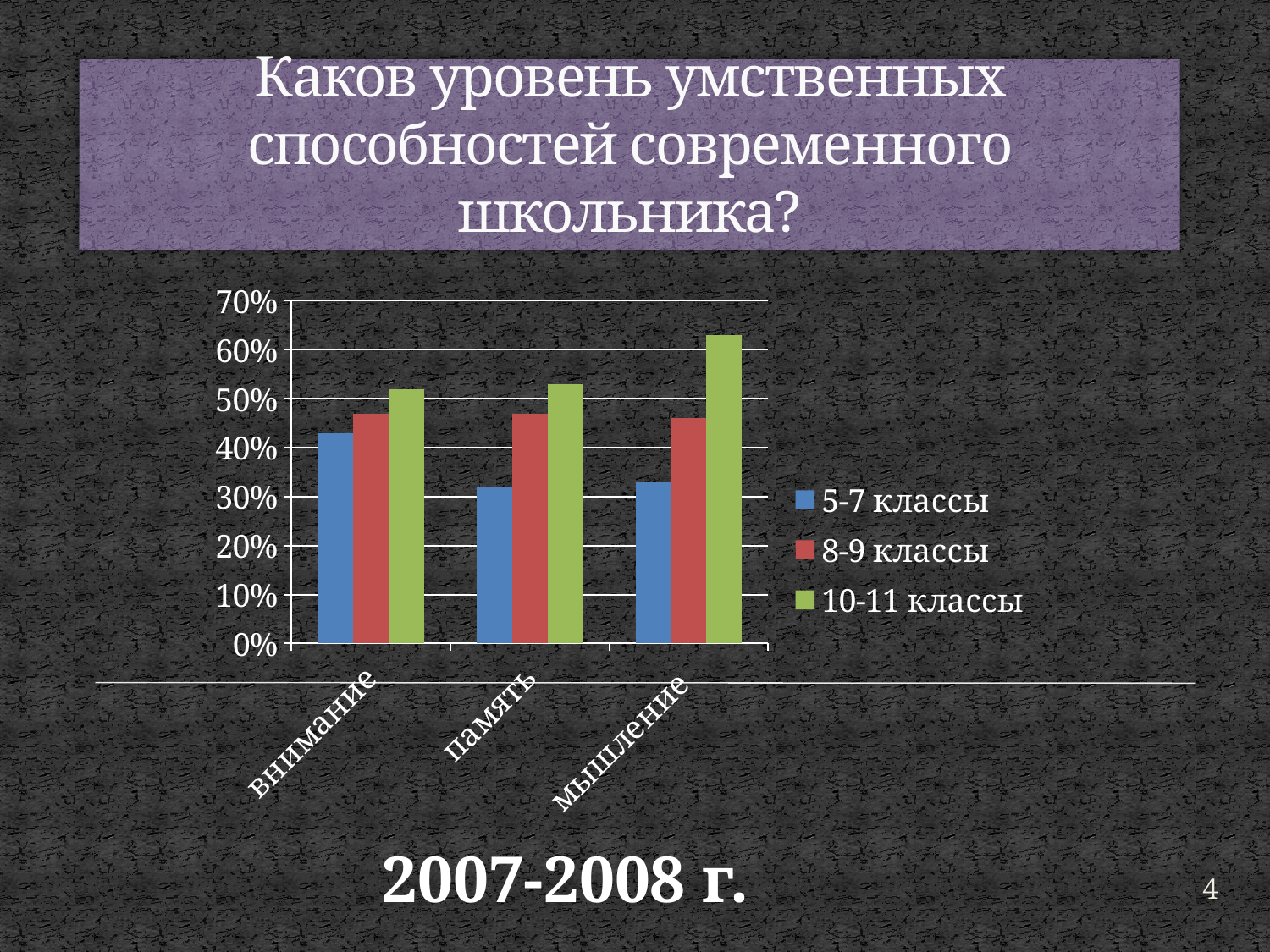
Is the value for 10-11 классы in мышление greater or less than 60%? greater What kind of chart is shown on the slide? bar chart Which series and category has the tallest bar in the chart? 10-11 классы, мышление For the 5-7 классы series, which category has the highest value? внимание For the 10-11 классы series, which category has the highest value? мышление How many categories are shown on the x axis of the chart? 3 Is the value for 5-7 классы in внимание greater or less than 40%? greater For мышление, which is larger: the value for 10-11 классы or for 5-7 классы? 10-11 классы For память, which is larger: the value for 8-9 классы or for 5-7 классы? 8-9 классы Is the value for 5-7 классы in память greater or less than 40%? less How many series does the chart's legend list? 3 What colour are the bars for the 10-11 классы series? green